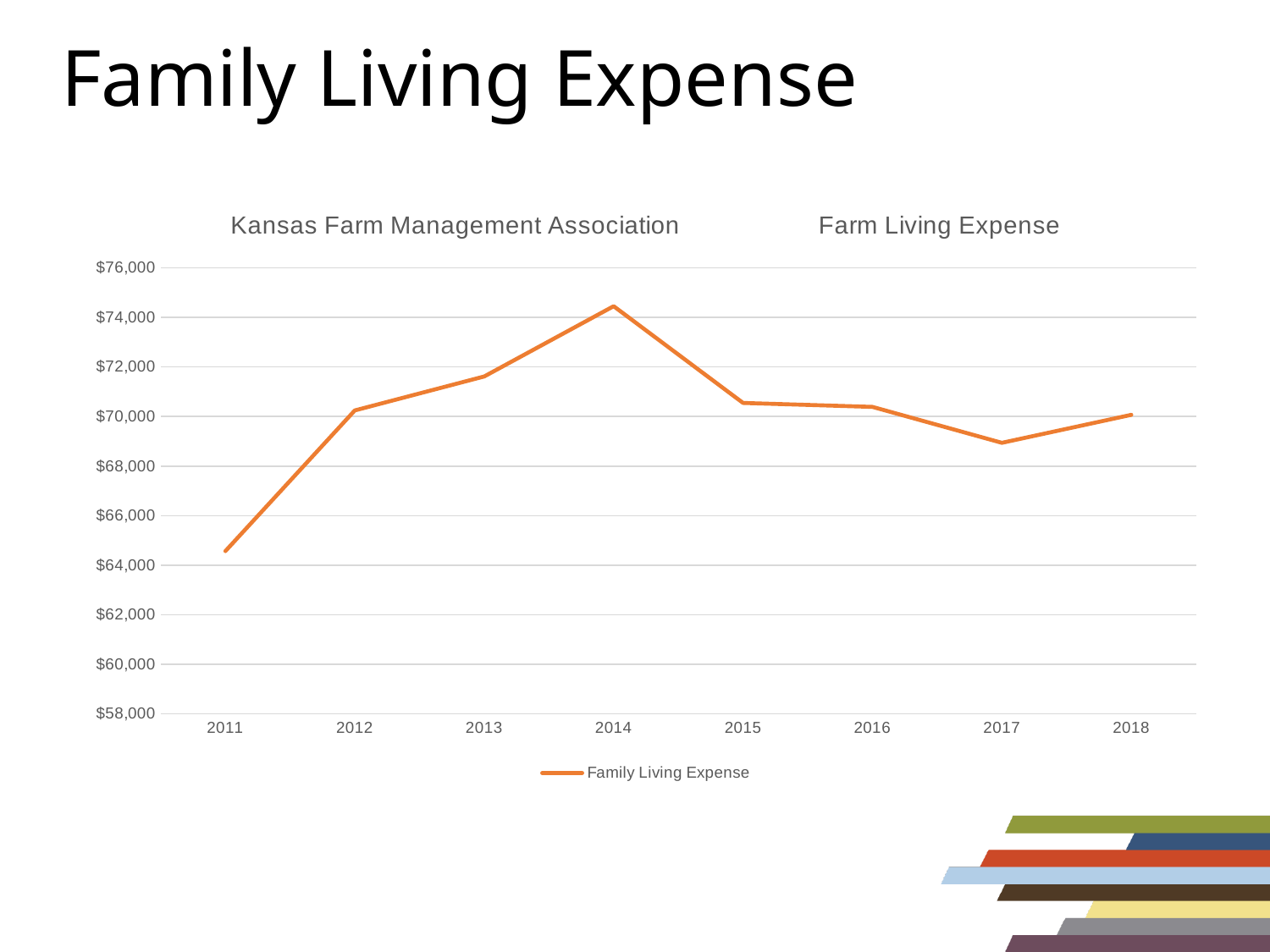
Which year has the lowest Family Living Expense? 2011 Is the Family Living Expense for 2013 greater or less than $70,000? greater Is the Family Living Expense for 2017 greater or less than $70,000? less What kind of chart is shown on the slide? line chart What is the name of the series shown in the chart legend? Family Living Expense Which year has the highest Family Living Expense? 2014 How many years are plotted on the x axis of the chart? 8 How many series does the chart legend list? 1 Is the Family Living Expense for 2011 greater or less than $66,000? less Does the Family Living Expense rise or fall from 2011 to 2014? rise Which year has a higher Family Living Expense, 2013 or 2017? 2013